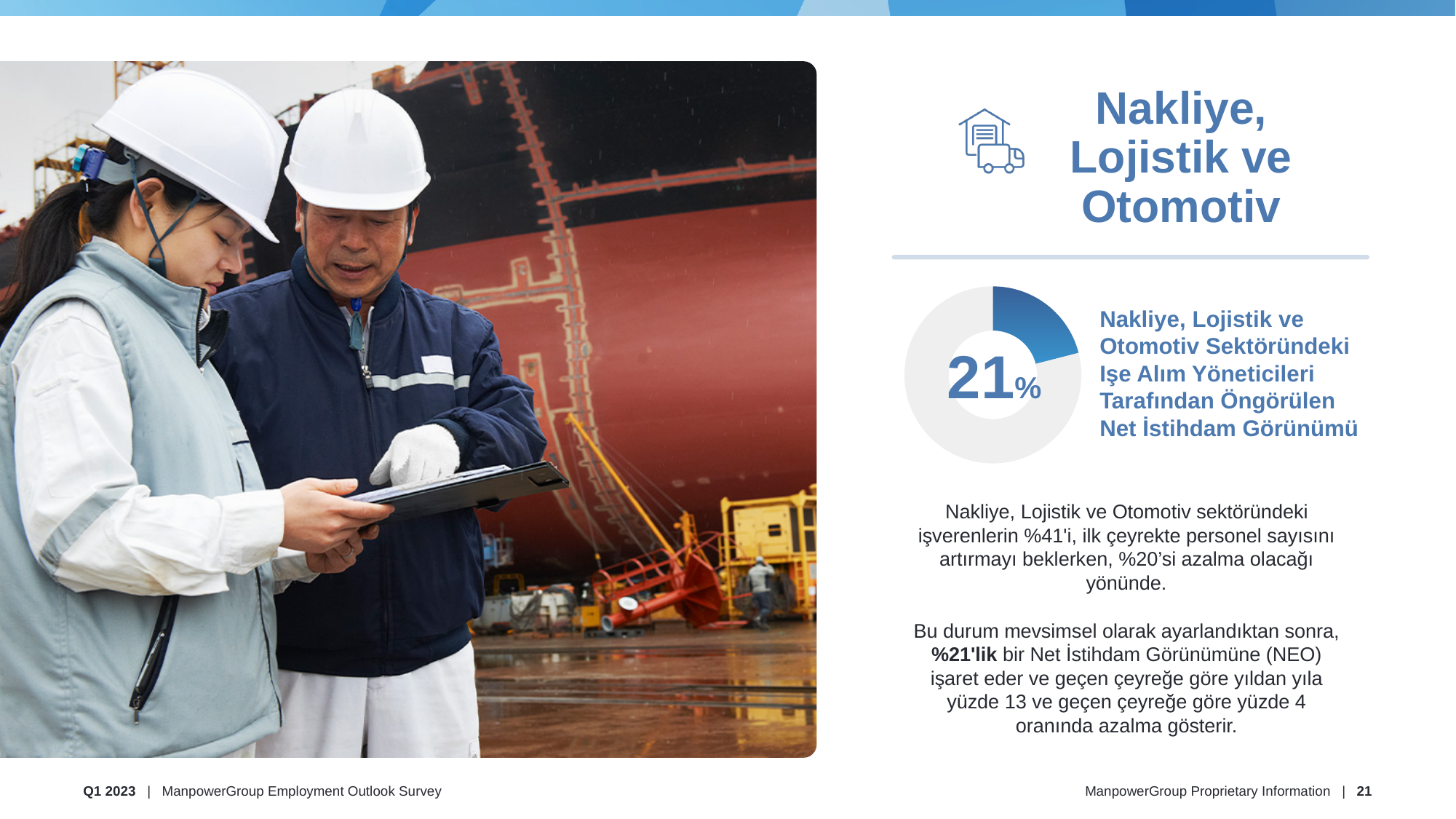
Is the highlighted slice of the donut chart greater or less than 50% of the whole? less What kind of chart is shown next to the text 'Nakliye, Lojistik ve Otomotiv Sektöründeki Işe Alım Yöneticileri Tarafından Öngörülen Net İstihdam Görünümü'? Donut (pie) chart What share of the donut chart does the highlighted blue slice represent? 21% What value is displayed in the centre of the donut chart? 21% Is the highlighted slice of the donut chart greater or less than 10% of the whole? greater What colour is the highlighted slice of the donut chart? Blue According to the label beside the donut chart, what does the 21% figure represent? Nakliye, Lojistik ve Otomotiv Sektöründeki Işe Alım Yöneticileri Tarafından Öngörülen Net İstihdam Görünümü